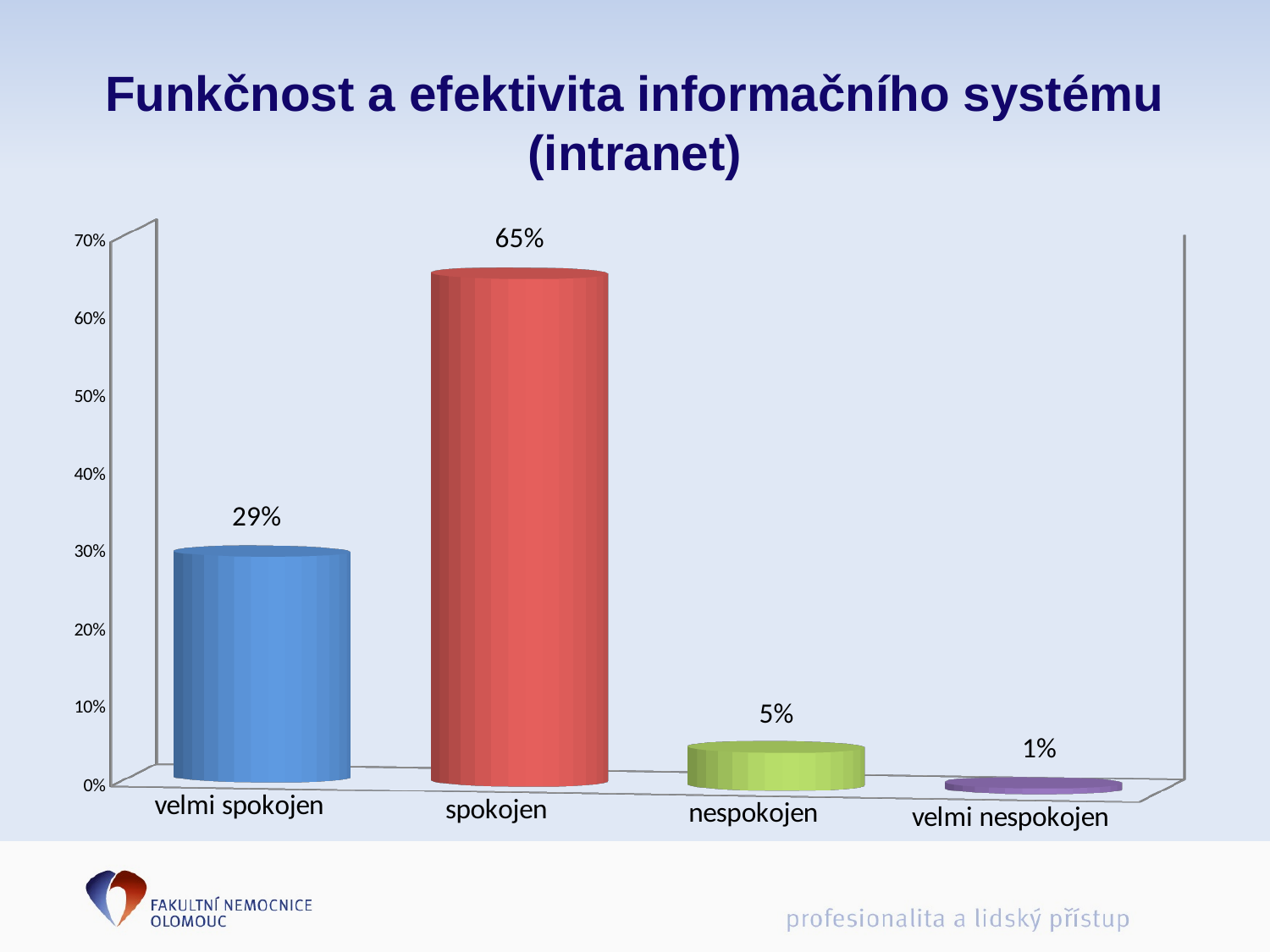
Which category has the highest value? spokojen How many categories are shown on the x axis? 4 Which category has the lowest value? velmi nespokojen What is the value for "velmi nespokojen"? 1% Is the value for "velmi spokojen" greater or less than 30%? less What is the value for "nespokojen"? 5% What is the value for "velmi spokojen"? 29% What is the title of the chart on the slide? Funkčnost a efektivita informačního systému (intranet) What kind of chart is shown on the slide? bar chart Which is larger, the value for "velmi spokojen" or the value for "nespokojen"? velmi spokojen What is the difference between the values for "spokojen" and "velmi spokojen"? 36% What is the value for "spokojen"? 65%